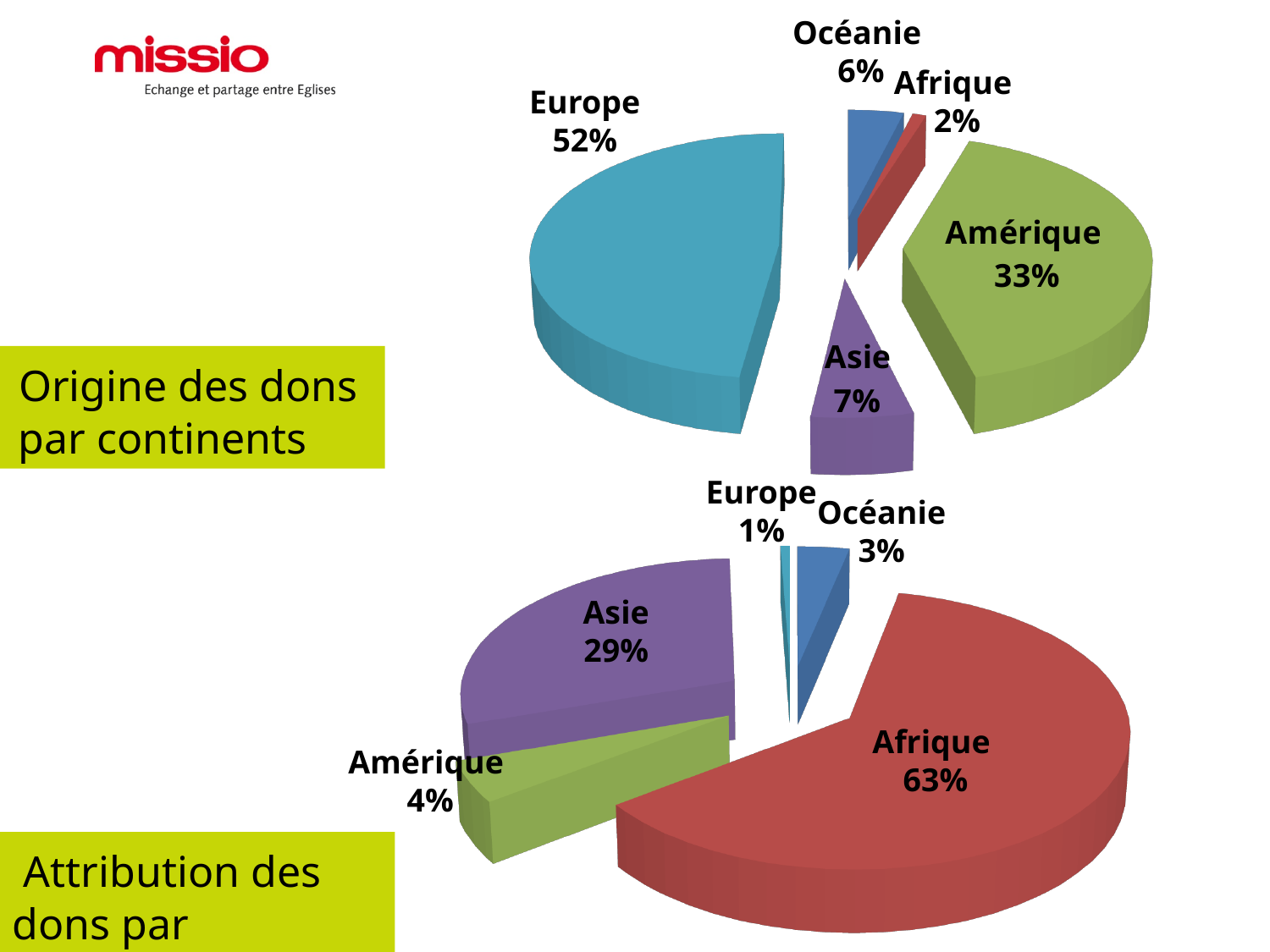
In the top chart (Origine des dons par continents), what share of donations comes from Amérique? 33% In the top chart (Origine des dons par continents), how many continents are shown? 5 In the top chart (Origine des dons par continents), which continent has the largest share? Europe In the bottom chart (Attribution des dons par continents), which is larger, the share for Océanie or the share for Amérique? Amérique In the top chart (Origine des dons par continents), which continent has the smallest share? Afrique In the top chart (Origine des dons par continents), what share of donations comes from Europe? 52% In the bottom chart (Attribution des dons par continents), what share of donations goes to Asie? 29% In the bottom chart (Attribution des dons par continents), what is the difference between the Afrique and Asie shares? 34% In the top chart (Origine des dons par continents), what is the difference between the Europe and Amérique shares? 19% What type of chart is used for both charts on the slide? Pie chart In the bottom chart (Attribution des dons par continents), what share of donations goes to Afrique? 63% In the bottom chart (Attribution des dons par continents), which continent receives the smallest share? Europe